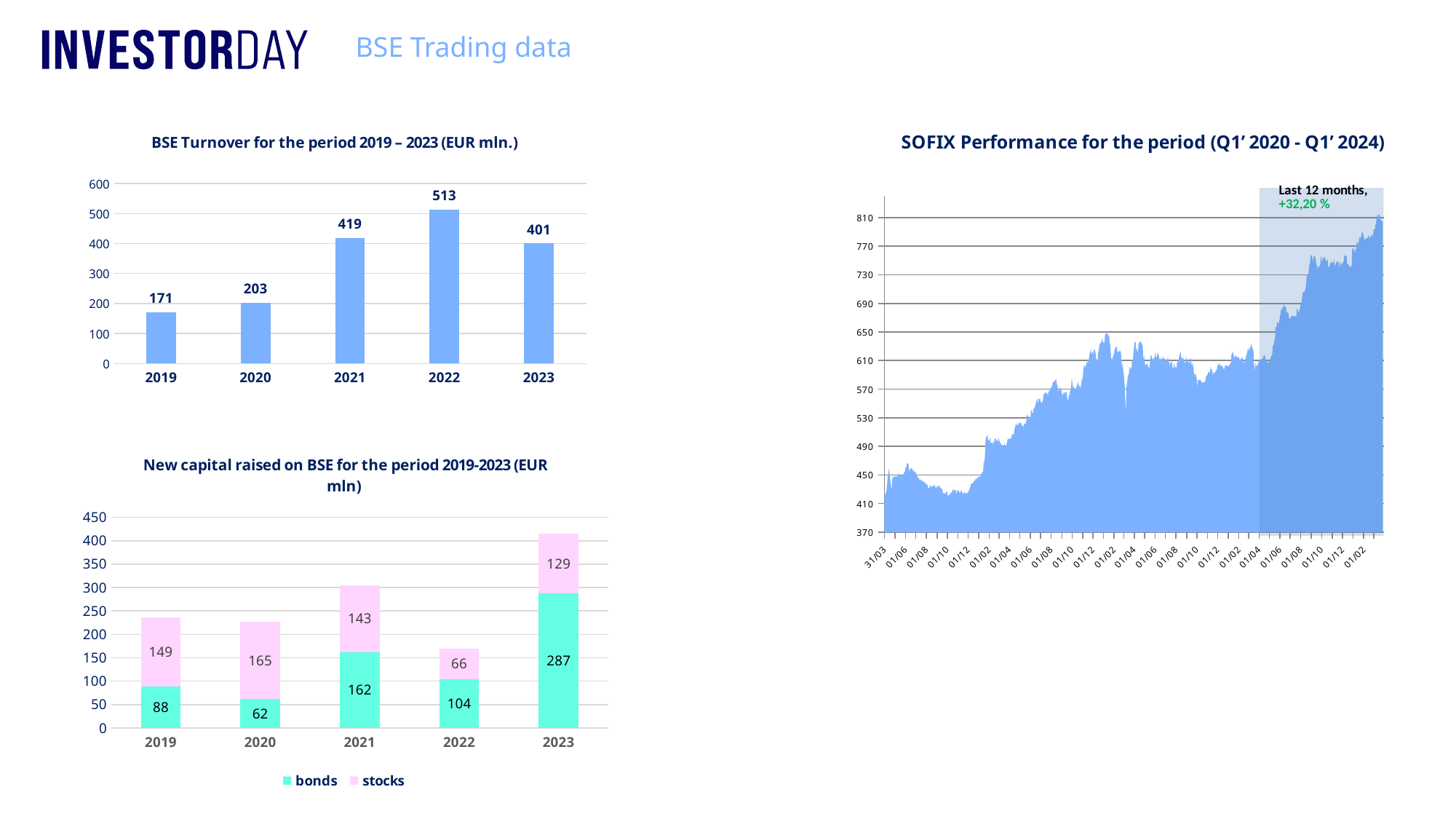
In the 'BSE Turnover for the period 2019 – 2023 (EUR mln.)' chart, what is the turnover for 2021? 419 In the 'BSE Turnover for the period 2019 – 2023 (EUR mln.)' chart, which year has the lowest turnover? 2019 What kind of chart is the 'SOFIX Performance for the period (Q1’ 2020 - Q1’ 2024)' chart? area chart In the 'New capital raised on BSE for the period 2019-2023 (EUR mln)' chart, what is the bonds value for 2023? 287 In the 'New capital raised on BSE for the period 2019-2023 (EUR mln)' chart, what is the total capital raised in 2021? 305 In the 'New capital raised on BSE for the period 2019-2023 (EUR mln)' chart, what is the stocks value for 2020? 165 In the 'BSE Turnover for the period 2019 – 2023 (EUR mln.)' chart, how many years are shown? 5 In the 'New capital raised on BSE for the period 2019-2023 (EUR mln)' chart, which is larger in 2019, bonds or stocks? stocks In the 'BSE Turnover for the period 2019 – 2023 (EUR mln.)' chart, which year has the highest turnover? 2022 In the 'BSE Turnover for the period 2019 – 2023 (EUR mln.)' chart, what is the difference between the 2022 and 2023 values? 112 In the 'SOFIX Performance for the period (Q1’ 2020 - Q1’ 2024)' chart, what percentage change is shown for the last 12 months? +32,20 % How many series does the legend of the 'New capital raised on BSE for the period 2019-2023 (EUR mln)' chart list? 2